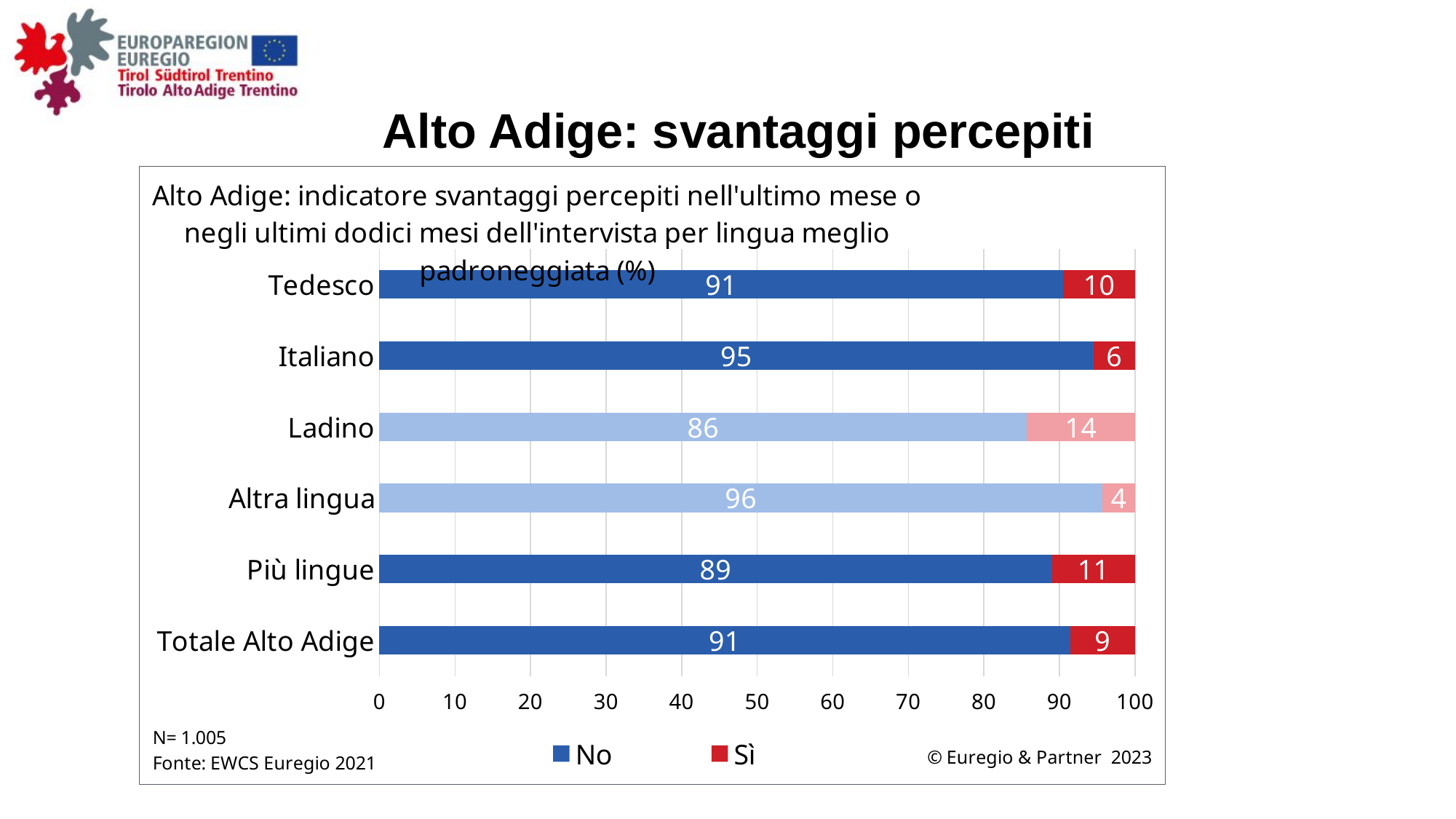
Which category has the lowest 'Sì' value? Altra lingua What is the 'No' value for Italiano? 95 Which is larger, the 'Sì' value for Tedesco or the 'Sì' value for Italiano? Tedesco How many series does the legend list? 2 What is the total of the stacked bar for Tedesco? 101 What is the difference between the 'No' values for Altra lingua and Ladino? 10 Which category has the highest 'Sì' value? Ladino What is the 'No' value for Totale Alto Adige? 91 What kind of chart is shown? Stacked bar chart How many categories are shown on the y axis? 6 What is the 'Sì' value for Più lingue? 11 What is the 'Sì' value for Ladino? 14